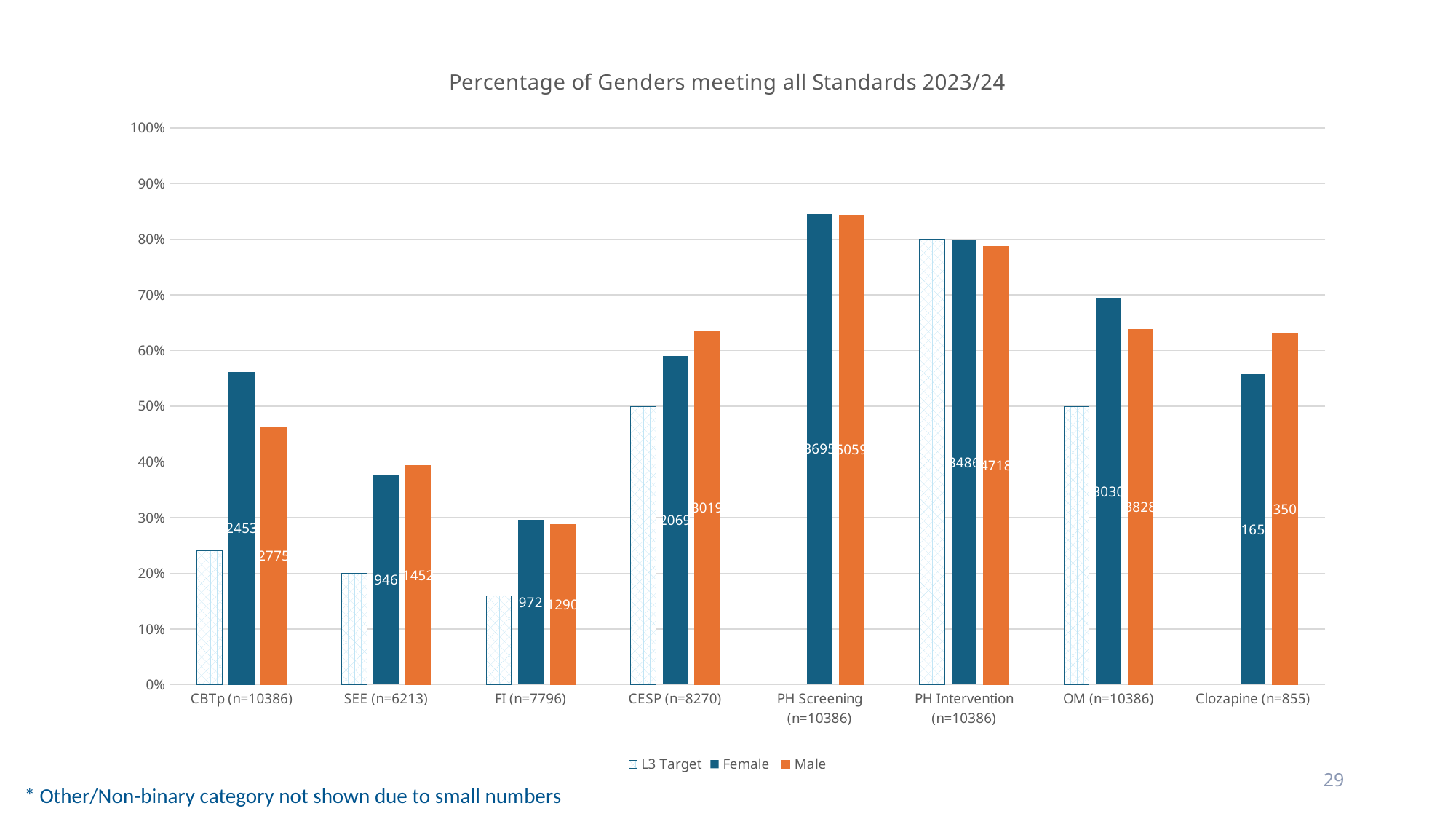
What is the title of the chart? Percentage of Genders meeting all Standards 2023/24 What is the L3 Target value for CESP (n=8270)? 50% Is the Female value for OM (n=10386) greater or less than 60%? greater What type of chart is shown on the slide? bar chart How many categories are shown on the x axis? 8 How many series does the legend list? 3 Which category has the highest Female percentage? PH Screening (n=10386) For CBTp (n=10386), which is larger, the Female or the Male percentage? Female What is the L3 Target value for PH Intervention (n=10386)? 80% What data label is printed on the Male bar for Clozapine (n=855)? 350 What data label is printed on the Female bar for CBTp (n=10386)? 2453 Which category has the lowest Male percentage? FI (n=7796)